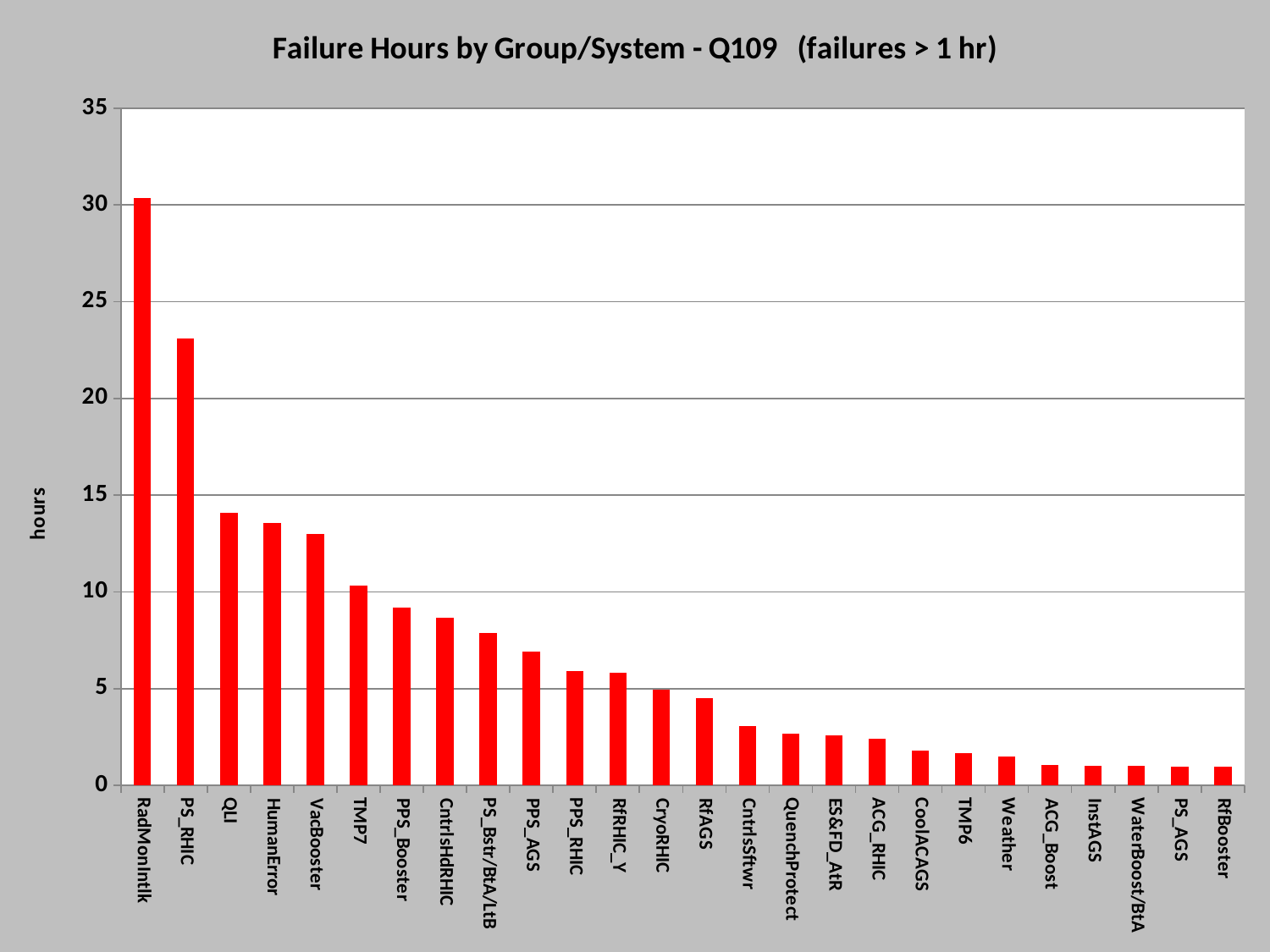
What is the label on the vertical axis? hours How many groups/systems are shown on the x axis? 26 Which group/system has the highest failure hours? RadMonIntlk What is the title of the chart? Failure Hours by Group/System - Q109 (failures > 1 hr) Is the value for PS_RHIC greater or less than 20? greater Is the value for QLI greater or less than 15? less Is the value for RadMonIntlk greater or less than 25? greater Which has more failure hours, PS_RHIC or QLI? PS_RHIC What kind of chart is shown on the slide? bar chart Do the failure hours rise or fall moving left to right along the x axis? fall Which has more failure hours, RfAGS or CntrlsSftwr? RfAGS